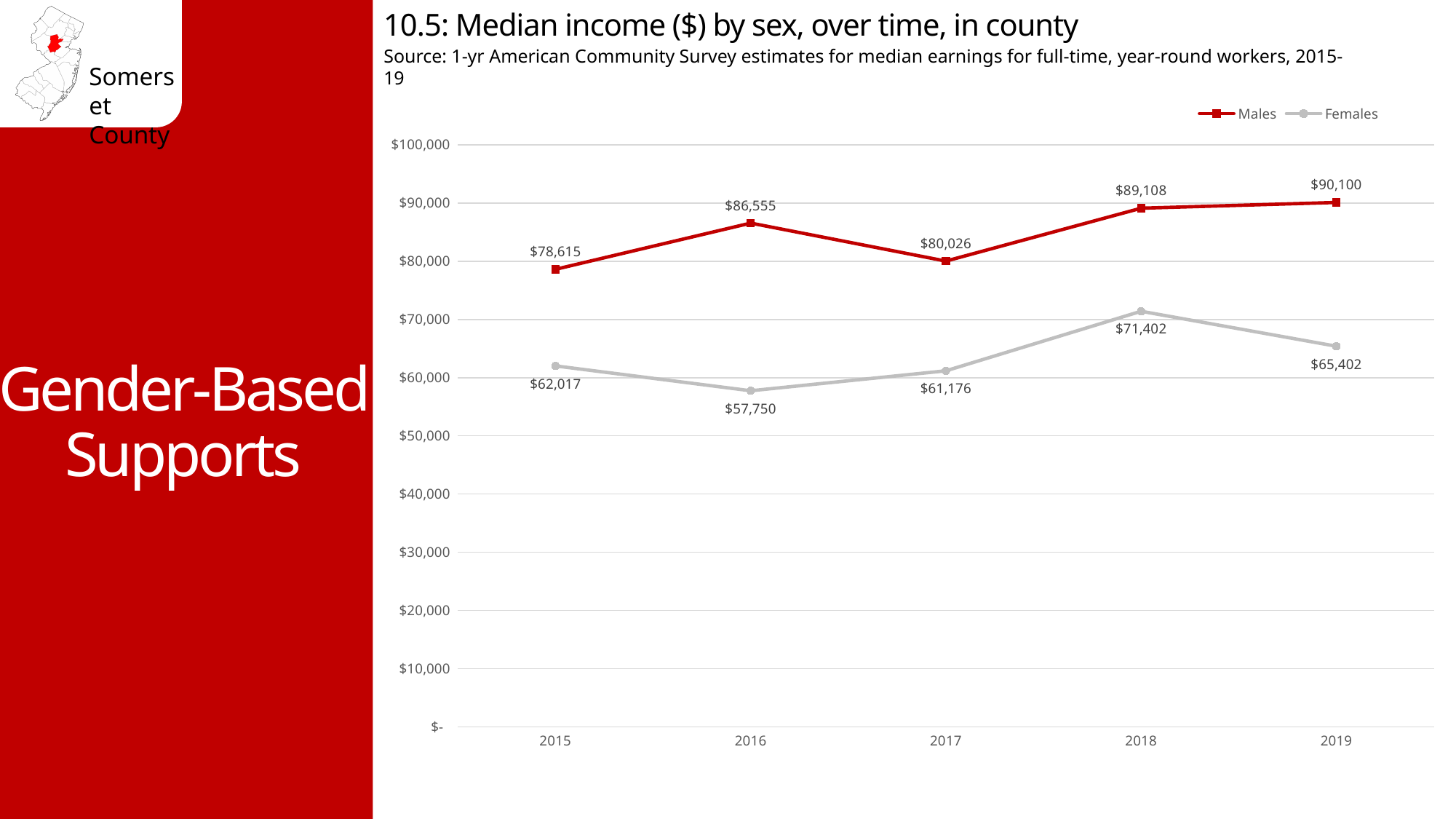
What is the difference between male and female median income in 2019? $24,698 Which colour is used for the Males series? Red What was the median income for females in 2016? $57,750 What kind of chart is shown on the slide? Line chart Which was larger: female median income in 2018 or female median income in 2019? 2018 How many series does the legend list? 2 What was the median income for males in 2017? $80,026 In which year was the median income for males highest? 2019 Is the value for females in 2018 greater or less than $70,000? greater How many years are shown on the x axis? 5 In which year was the median income for females lowest? 2016 Did the median income for males rise or fall from 2016 to 2017? Fall